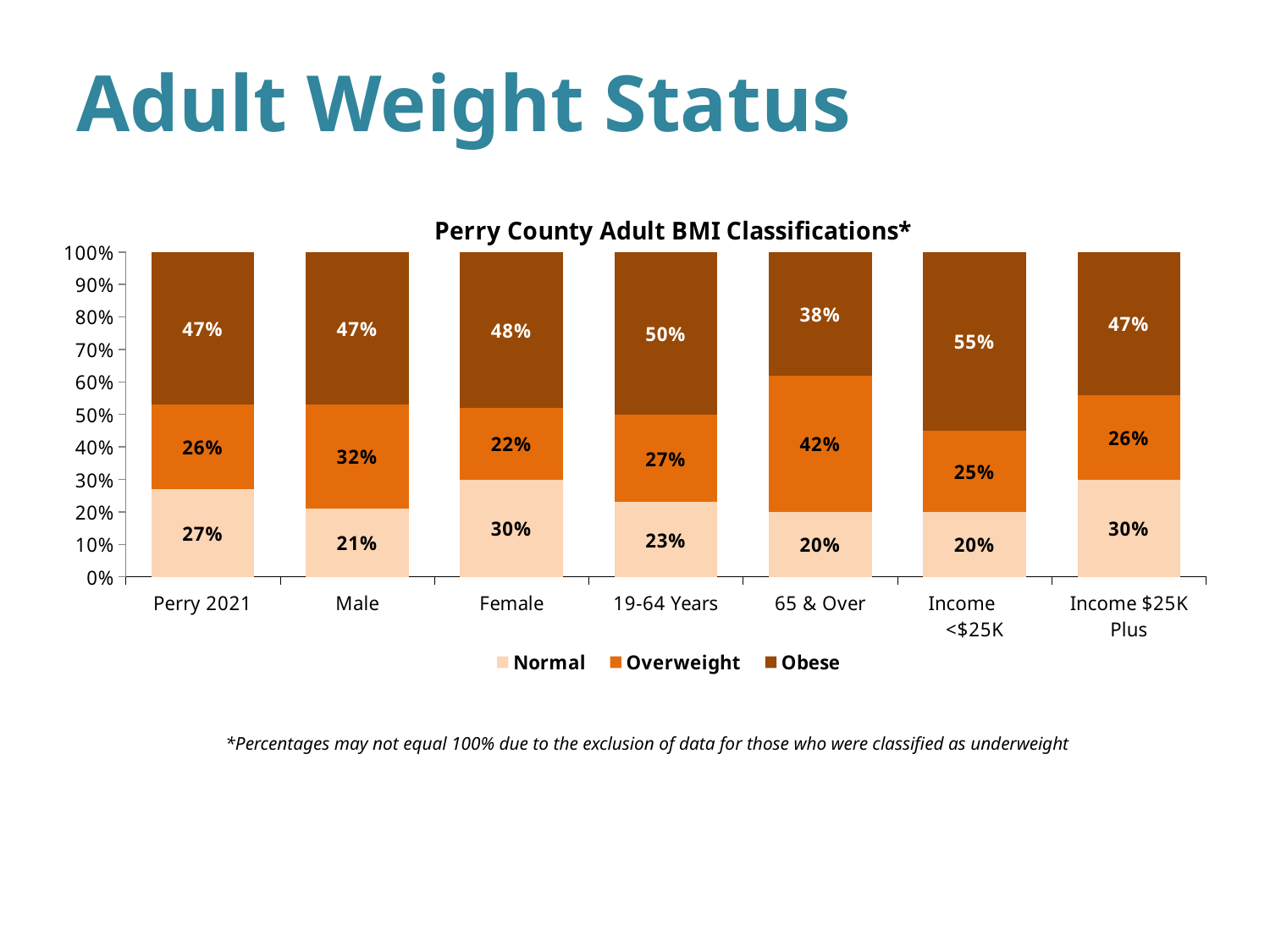
What is the difference between the Overweight percentages for Male and Female? 10% What is the Obese percentage for Income <$25K? 55% Which category has the highest Obese percentage? Income <$25K What is the Overweight percentage for 65 & Over? 42% What type of chart is shown? Stacked bar chart Which is larger, the Normal percentage for Male or for Female? Female How many series does the legend list? 3 Which category has the highest Overweight percentage? 65 & Over What is the Normal percentage for Perry 2021? 27% How many categories are shown on the x axis? 7 What is the Normal percentage for Female? 30% Which category has the lowest Obese percentage? 65 & Over